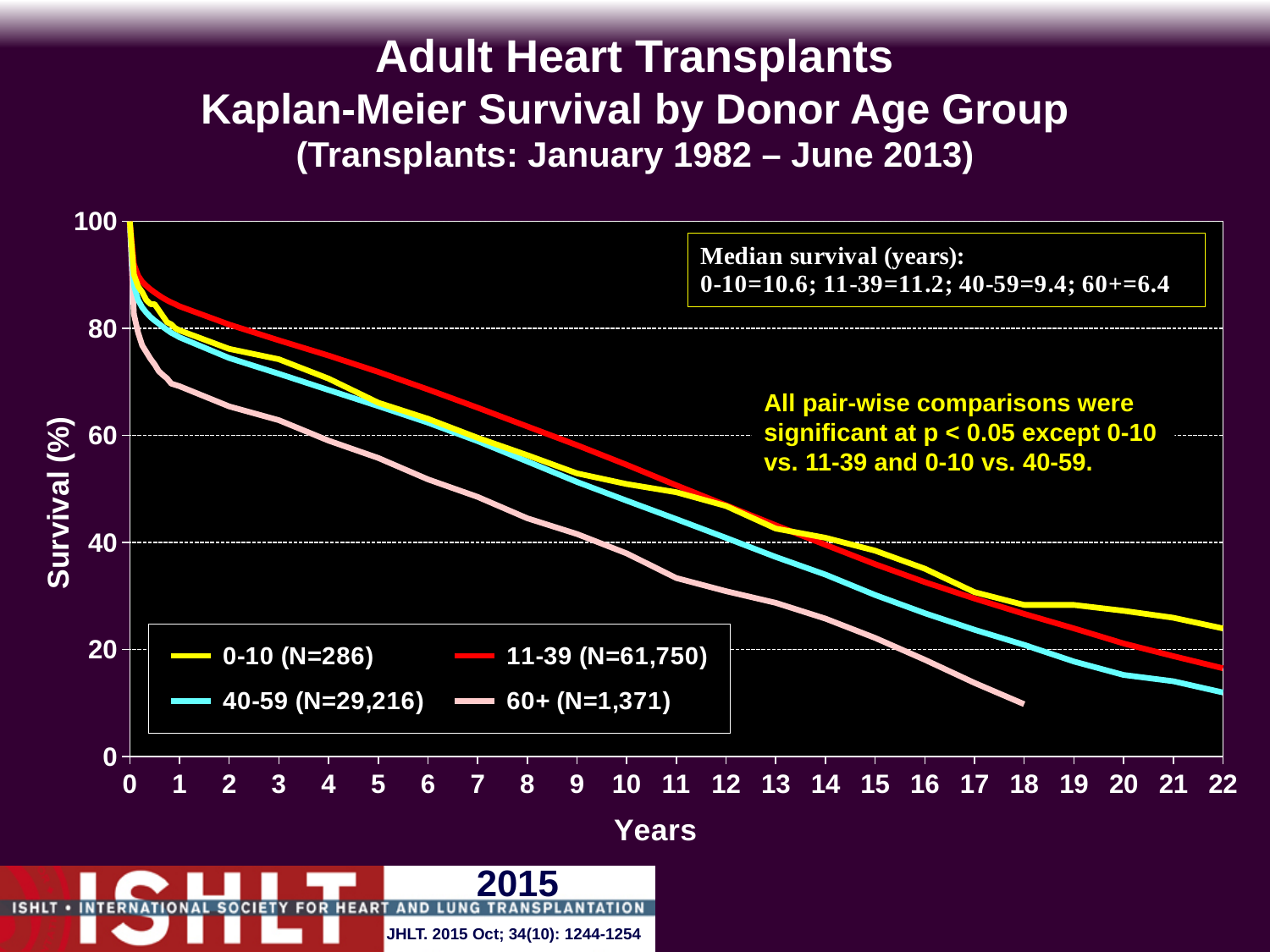
What is the difference in median survival (years) between the 11-39 group and the 60+ group? 4.8 What is the median survival in years for the 11-39 donor age group? 11.2 Is the survival for the 0-10 group at 20 years greater or less than 20? greater How many transplants (N) are in the 40-59 donor age group? 29,216 Which donor age group has the lowest median survival? 60+ Which donor age group has the highest median survival? 11-39 Do the survival curves rise or fall as years increase? fall Is the survival for the 60+ group at 5 years greater or less than 60? less What is the median survival in years for the 60+ donor age group? 6.4 How many donor age groups does the legend list? 4 Which has the larger median survival, the 0-10 group or the 40-59 group? 0-10 What kind of chart is shown on the slide? line chart